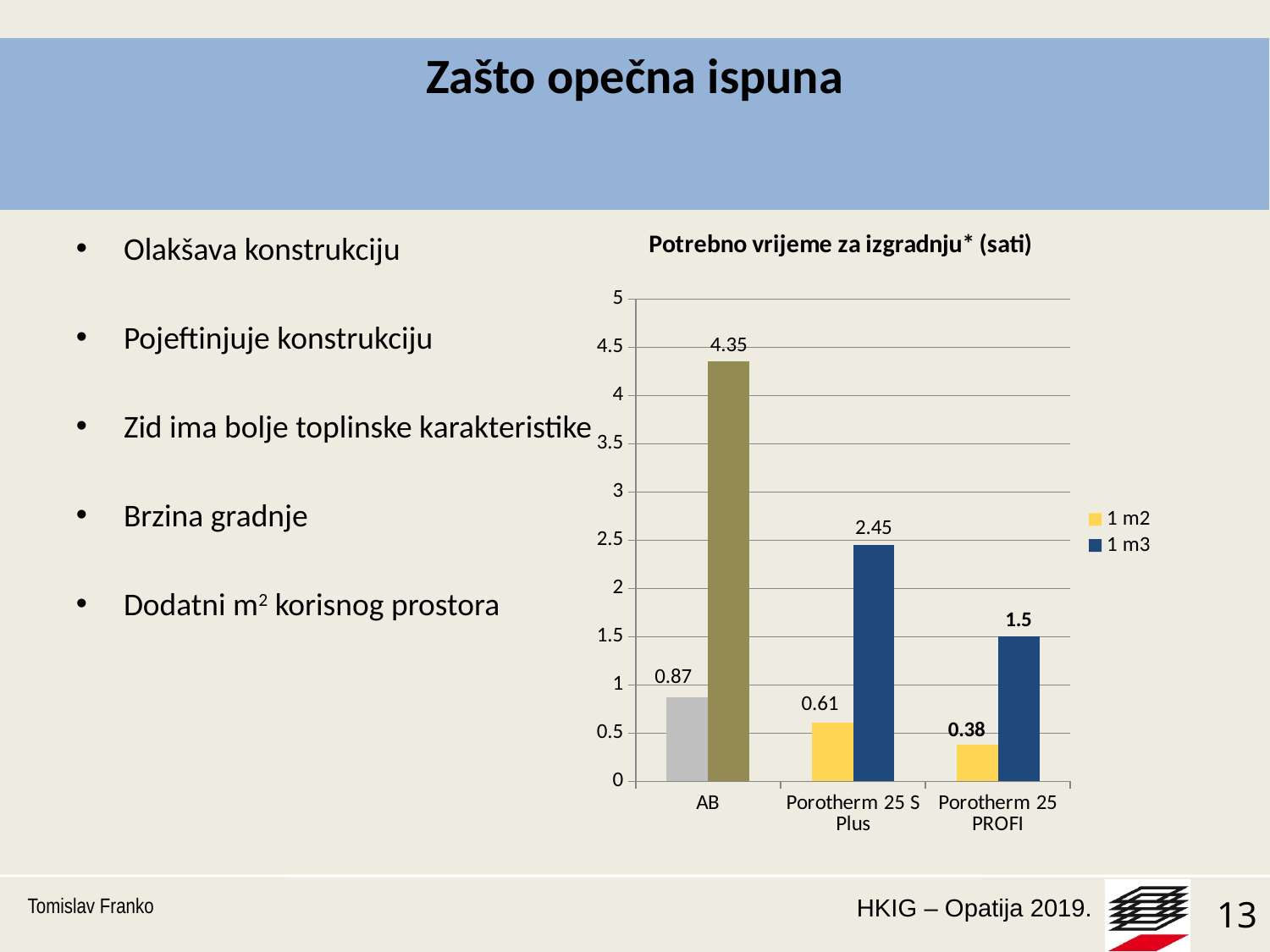
How many categories are shown on the x axis of the chart? 3 How many series does the chart legend list? 2 What is the value of the 1 m2 series for Porotherm 25 PROFI? 0.38 Which category has the lowest value in the chart? Porotherm 25 PROFI What kind of chart is shown on the slide? bar chart What is the highest value shown in the chart, and for which category? 4.35, AB What is the value of the 1 m3 series for Porotherm 25 S Plus? 2.45 What is the value of the 1 m3 series for Porotherm 25 PROFI? 1.5 What is the value of the 1 m2 series for Porotherm 25 S Plus? 0.61 What is the title of the chart? Potrebno vrijeme za izgradnju* (sati) What is the difference between the 1 m3 values for Porotherm 25 S Plus and Porotherm 25 PROFI? 0.95 Is the 1 m3 value for Porotherm 25 S Plus greater or less than 2? greater